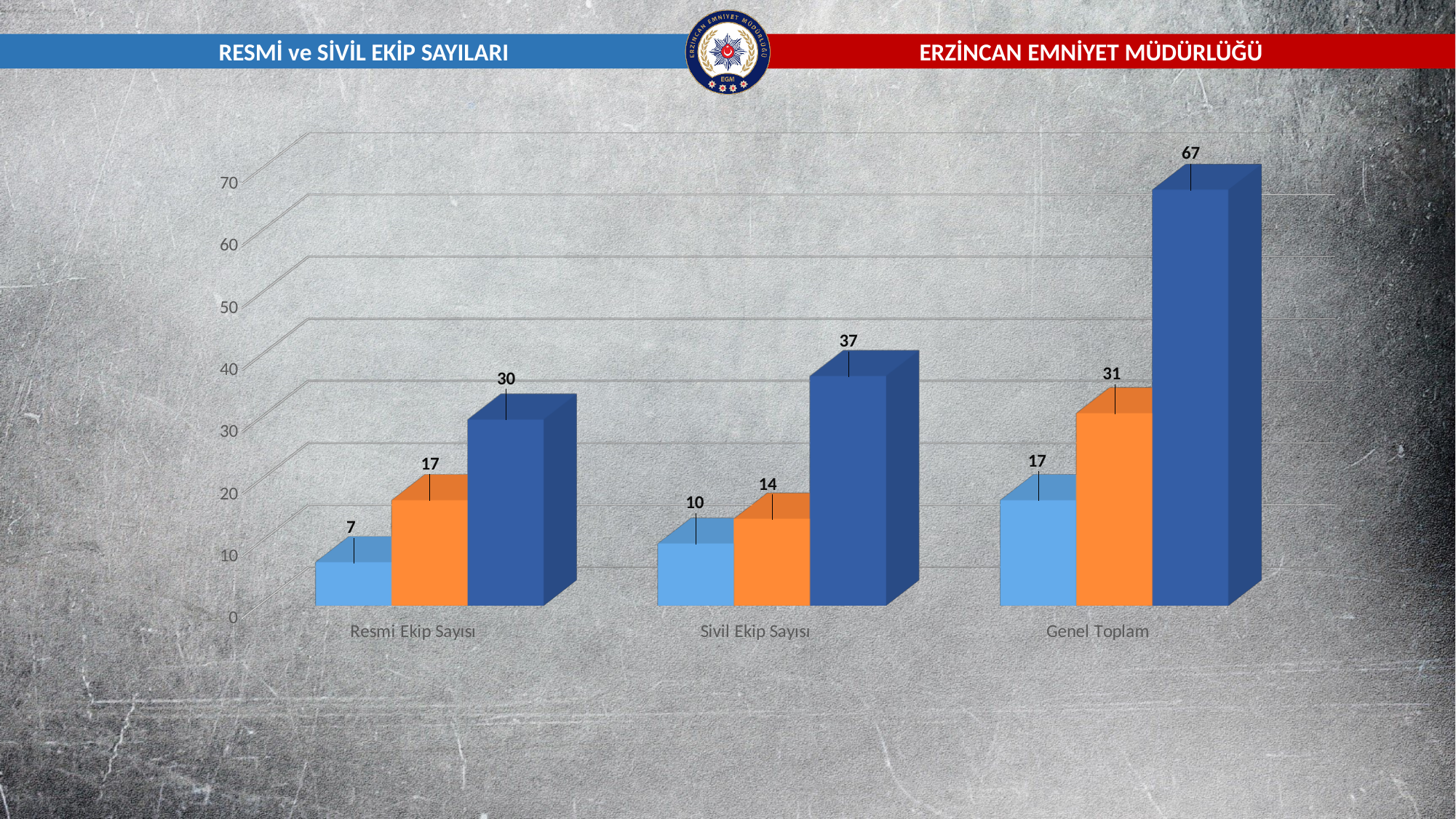
How many categories are shown on the x axis? 3 Which category has the highest dark blue bar? Genel Toplam What is the title shown in the blue header bar of the slide? RESMİ ve SİVİL EKİP SAYILARI Which category has the lowest light blue bar? Resmi Ekip Sayısı What is the value of the orange bar for Sivil Ekip Sayısı? 14 What is the difference between the dark blue bars for Sivil Ekip Sayısı and Resmi Ekip Sayısı? 7 What is the value of the light blue bar for Resmi Ekip Sayısı? 7 What is the value of the dark blue bar for Genel Toplam? 67 Which is larger: the orange bar for Resmi Ekip Sayısı or the orange bar for Sivil Ekip Sayısı? Resmi Ekip Sayısı What is the value of the orange bar for Genel Toplam? 31 What kind of chart is shown on the slide? Bar chart Is the dark blue bar for Sivil Ekip Sayısı greater or less than 40? less